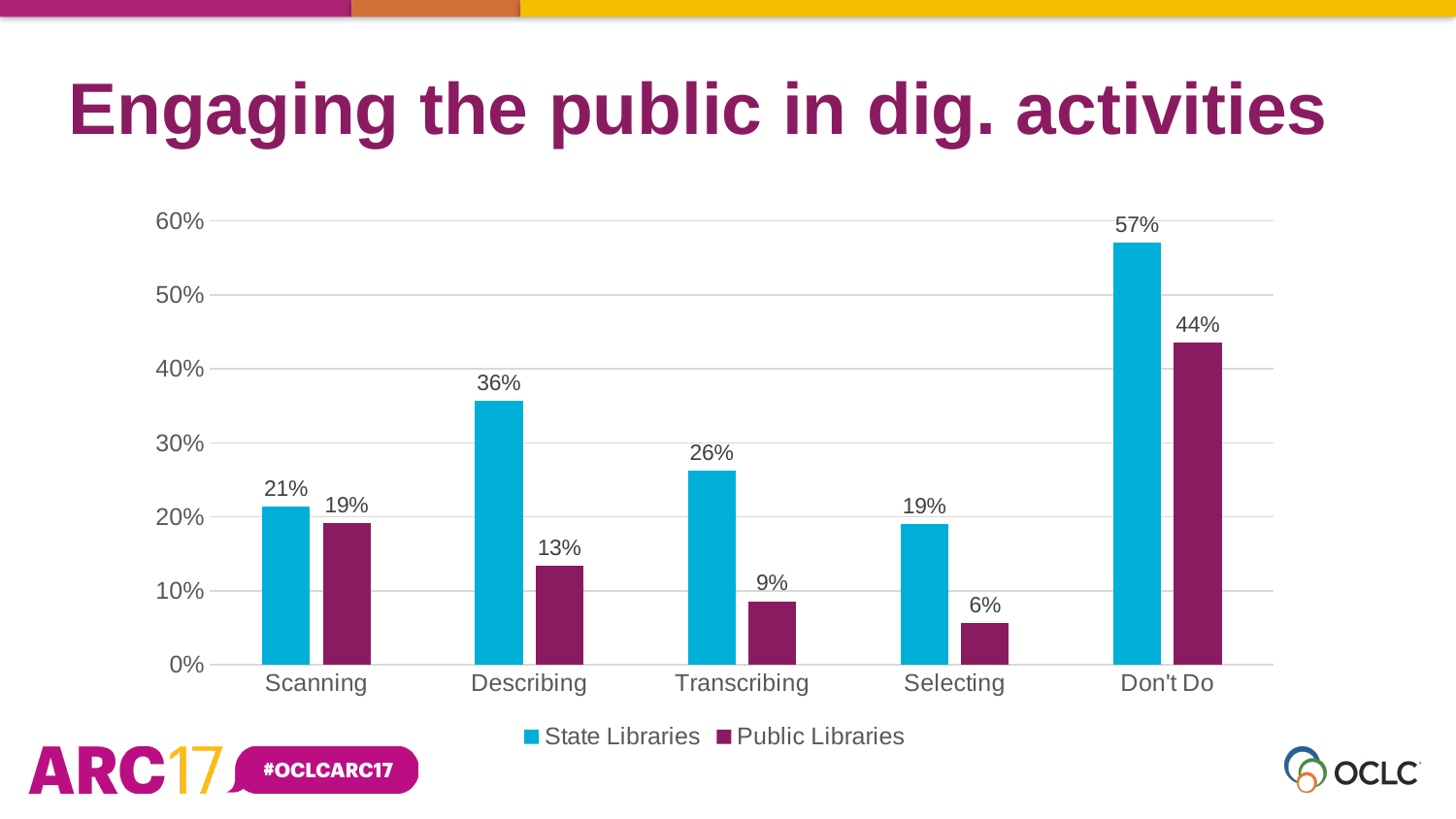
What is the value for Public Libraries in the Selecting category? 6% What kind of chart is shown on the slide? Bar chart Is the value for State Libraries in the Don't Do category greater or less than 50%? greater What is the difference between State Libraries and Public Libraries in the Transcribing category? 17% How many series does the legend list? 2 What is the value for State Libraries in the Describing category? 36% Which category has the lowest value for Public Libraries? Selecting What is the value for Public Libraries in the Don't Do category? 44% Which is larger: State Libraries for Scanning or Public Libraries for Scanning? State Libraries for Scanning What is the title of the chart on the slide? Engaging the public in dig. activities Which category has the highest value for State Libraries? Don't Do How many categories are shown on the x axis? 5